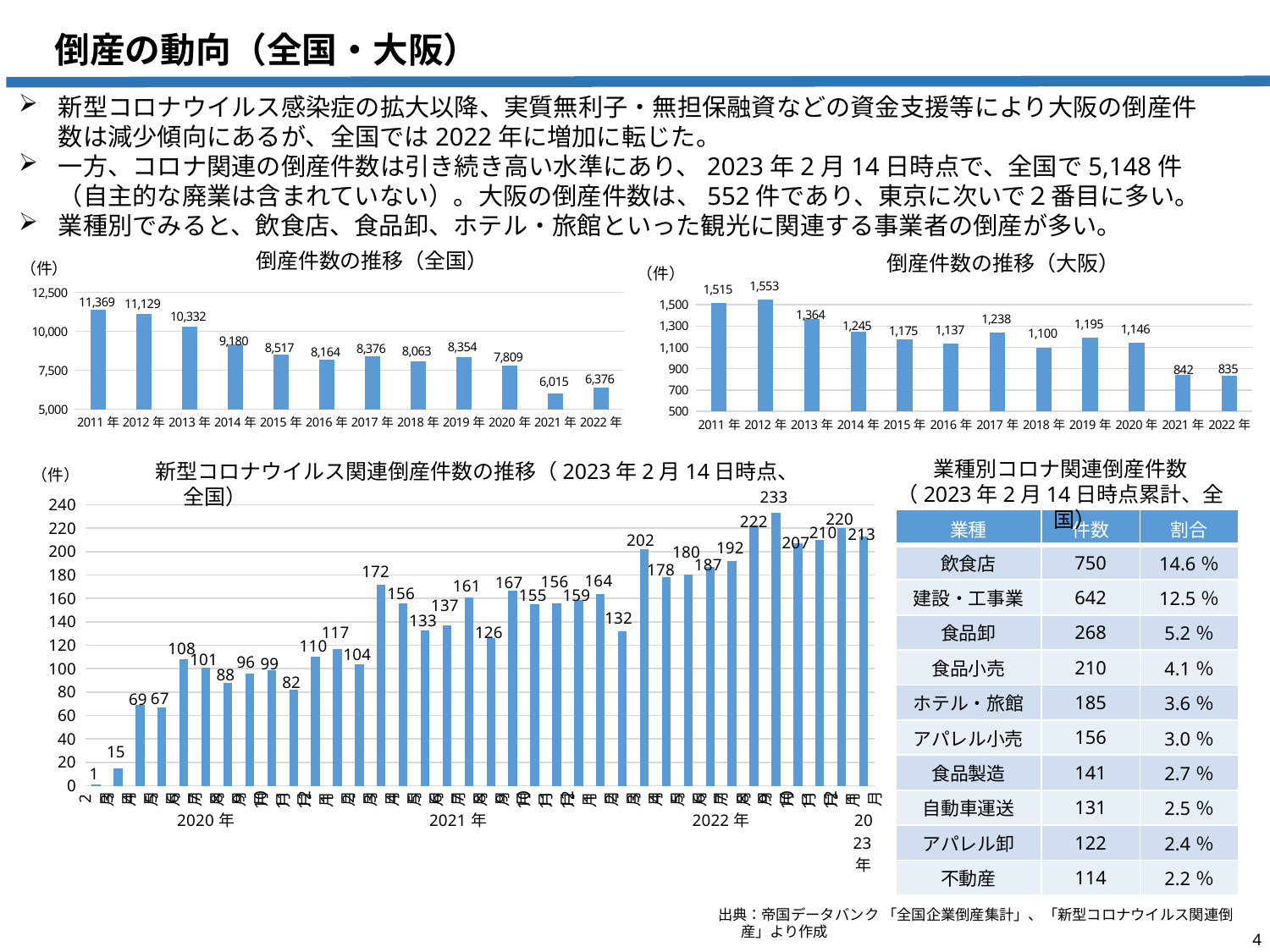
In the 倒産件数の推移（全国） chart, which year has the highest value? 2011年 In the 倒産件数の推移（全国） chart, which is larger, the value for 2017年 or 2018年? 2017年 In the 倒産件数の推移（全国） chart, what is the difference between the values for 2022年 and 2021年? 361 In the 新型コロナウイルス関連倒産件数の推移 chart at the bottom, what is the highest value shown? 233 In the 倒産件数の推移（全国） chart, what is the value for 2022年? 6,376 How many years are shown in the 倒産件数の推移（大阪） chart? 12 In the 倒産件数の推移（大阪） chart, what is the difference between the values for 2021年 and 2022年? 7 What kind of chart is the 倒産件数の推移（全国） chart? Bar chart In the 倒産件数の推移（全国） chart, which year has the lowest value? 2021年 In the 倒産件数の推移（大阪） chart, what is the value for 2012年? 1,553 In the 倒産件数の推移（大阪） chart, which year has the highest value? 2012年 In the 倒産件数の推移（全国） chart, what is the value for 2011年? 11,369